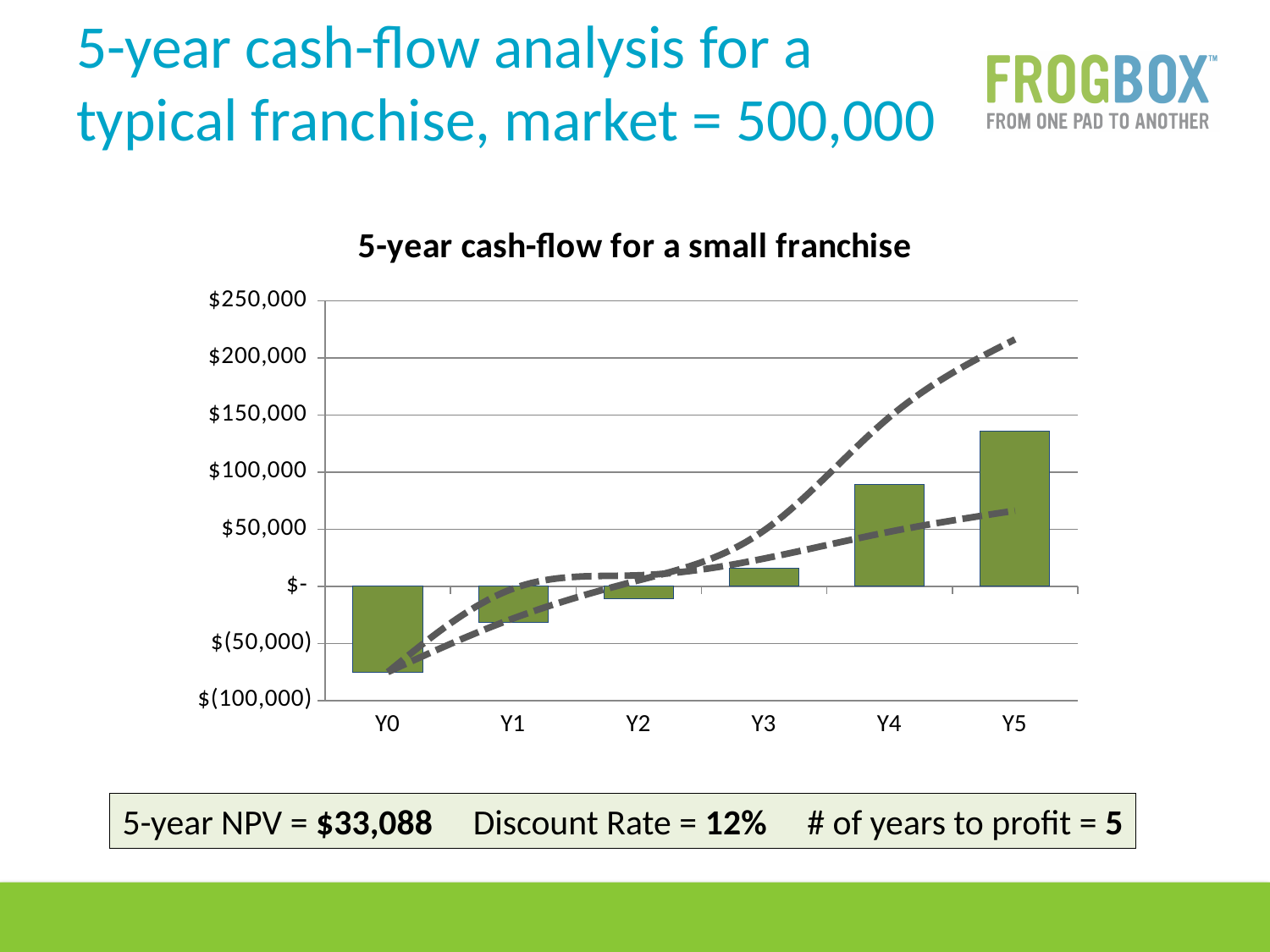
How many year categories are shown on the x axis of the chart? 6 Is the bar value for Y5 greater or less than $100,000? greater What is the title of the chart? 5-year cash-flow for a small franchise Do the bar values rise or fall from Y0 to Y5? rise Is the bar value for Y4 greater or less than $100,000? less What kind of chart is shown on the slide? combination bar and line chart Which year has the highest bar in the chart? Y5 Which bar is larger, Y4 or Y5? Y5 Is the bar value for Y3 greater or less than $50,000? less Which bar is larger, Y2 or Y3? Y3 Which year has the lowest bar in the chart? Y0